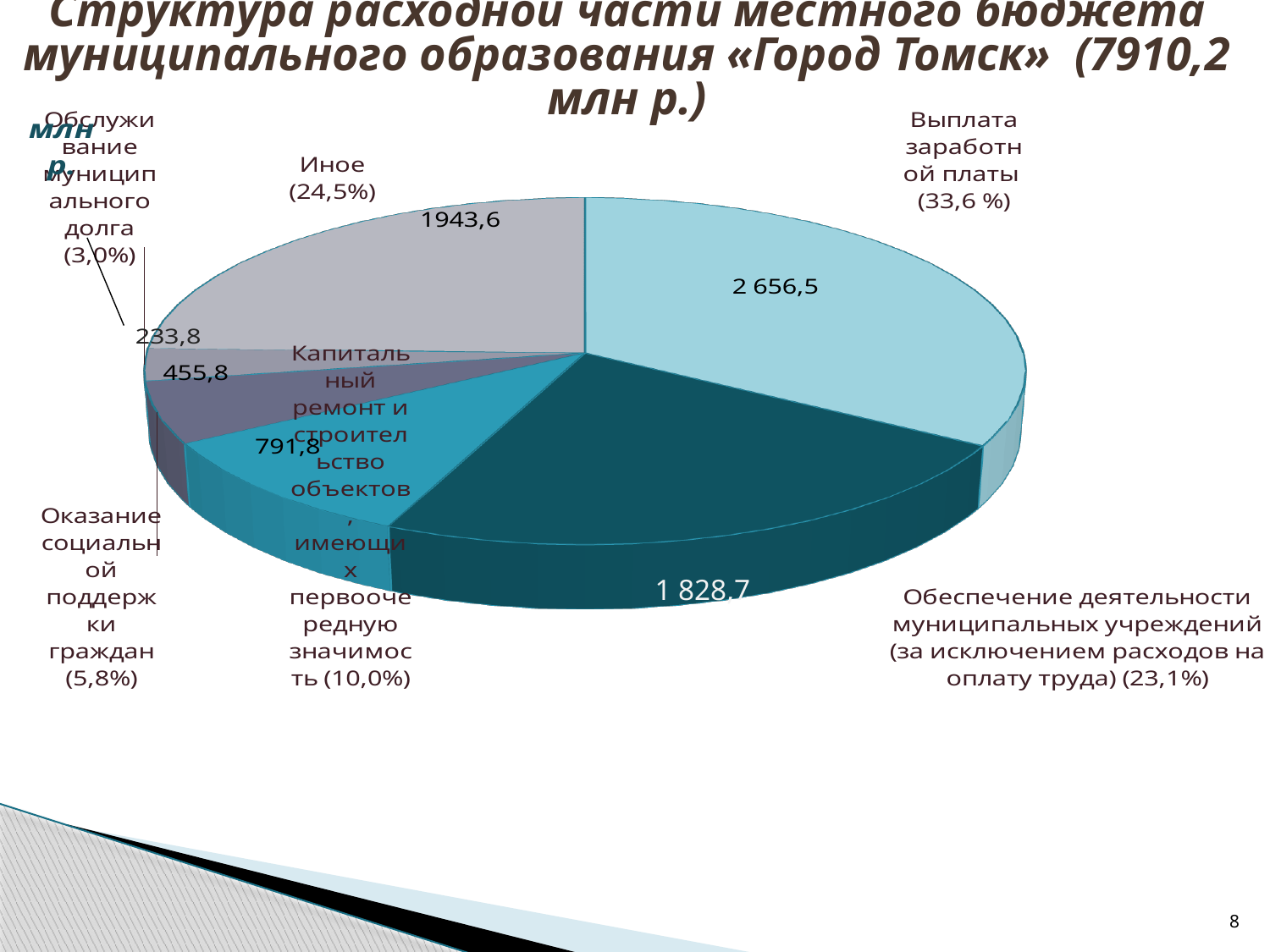
What is the value for «Выплата заработной платы»? 2 656,5 What is the value for «Обеспечение деятельности муниципальных учреждений (за исключением расходов на оплату труда)»? 1 828,7 Which category has the smallest slice of the pie? Обслуживание муниципального долга What kind of chart is shown on the slide? pie chart What is the value for «Оказание социальной поддержки граждан»? 455,8 What is the value for «Обслуживание муниципального долга»? 233,8 What is the difference between the value for «Выплата заработной платы» and the value for «Иное»? 712,9 Which category has the largest slice of the pie? Выплата заработной платы How many slices does the pie chart have? 6 What is the value for «Иное»? 1943,6 What share of the pie does «Капитальный ремонт и строительство объектов, имеющих первоочередную значимость» represent? 10,0% Which is larger: the value for «Иное» or the value for «Обеспечение деятельности муниципальных учреждений»? Иное